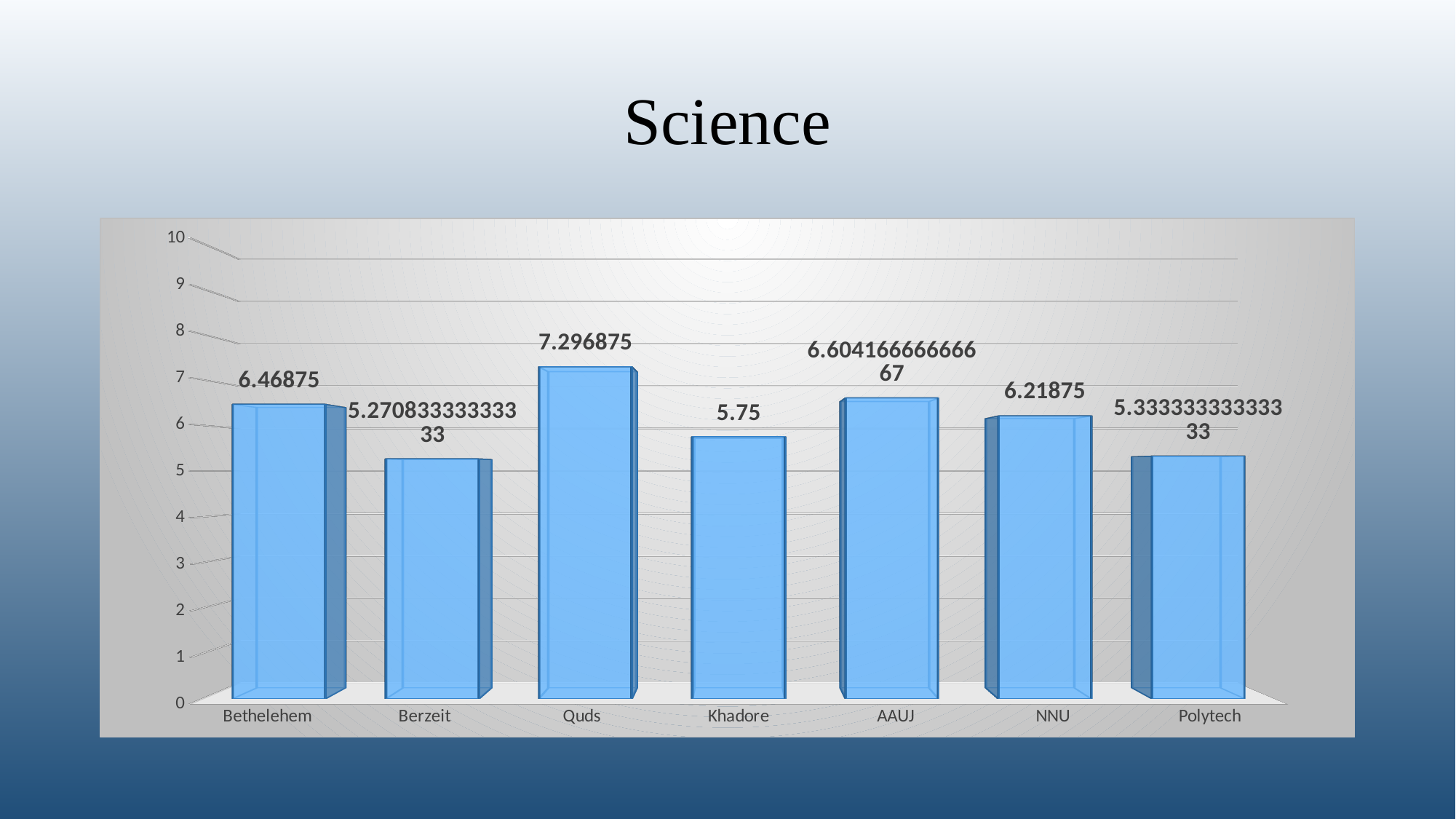
What kind of chart is shown on the slide? bar chart Which category has the highest value? Quds What is the value for Bethelehem? 6.46875 What is the difference between the values for Quds and Bethelehem? 0.828125 Which is larger, the value for AAUJ or the value for Khadore? AAUJ Which category has the lowest value? Berzeit How many categories are shown on the x axis? 7 What is the value for Quds? 7.296875 Is the value for Polytech greater or less than 6? less What is the value for NNU? 6.21875 What is the difference between the values for Bethelehem and NNU? 0.25 What is the value for Khadore? 5.75